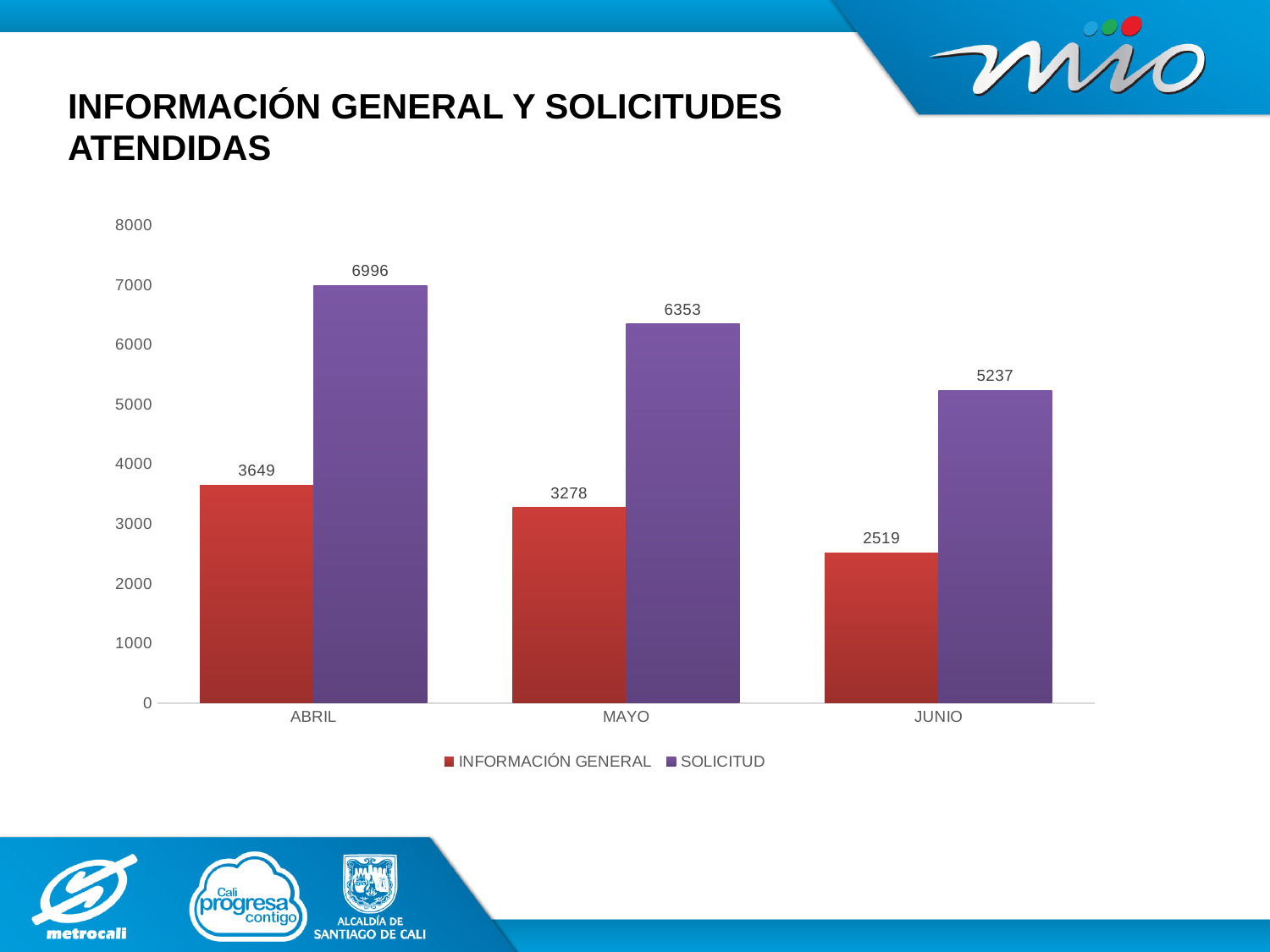
Which month has the highest SOLICITUD value? ABRIL What is the value for INFORMACIÓN GENERAL in JUNIO? 2519 What is the value for SOLICITUD in ABRIL? 6996 What is the difference between SOLICITUD and INFORMACIÓN GENERAL in MAYO? 3075 How many series does the legend list? 2 How many months are shown on the x axis? 3 Which is larger in JUNIO, INFORMACIÓN GENERAL or SOLICITUD? SOLICITUD Which month has the lowest INFORMACIÓN GENERAL value? JUNIO What is the value for INFORMACIÓN GENERAL in MAYO? 3278 What kind of chart is shown on the slide? Bar chart What is the difference between the SOLICITUD values for ABRIL and JUNIO? 1759 Do the SOLICITUD values rise or fall from ABRIL to JUNIO? Fall